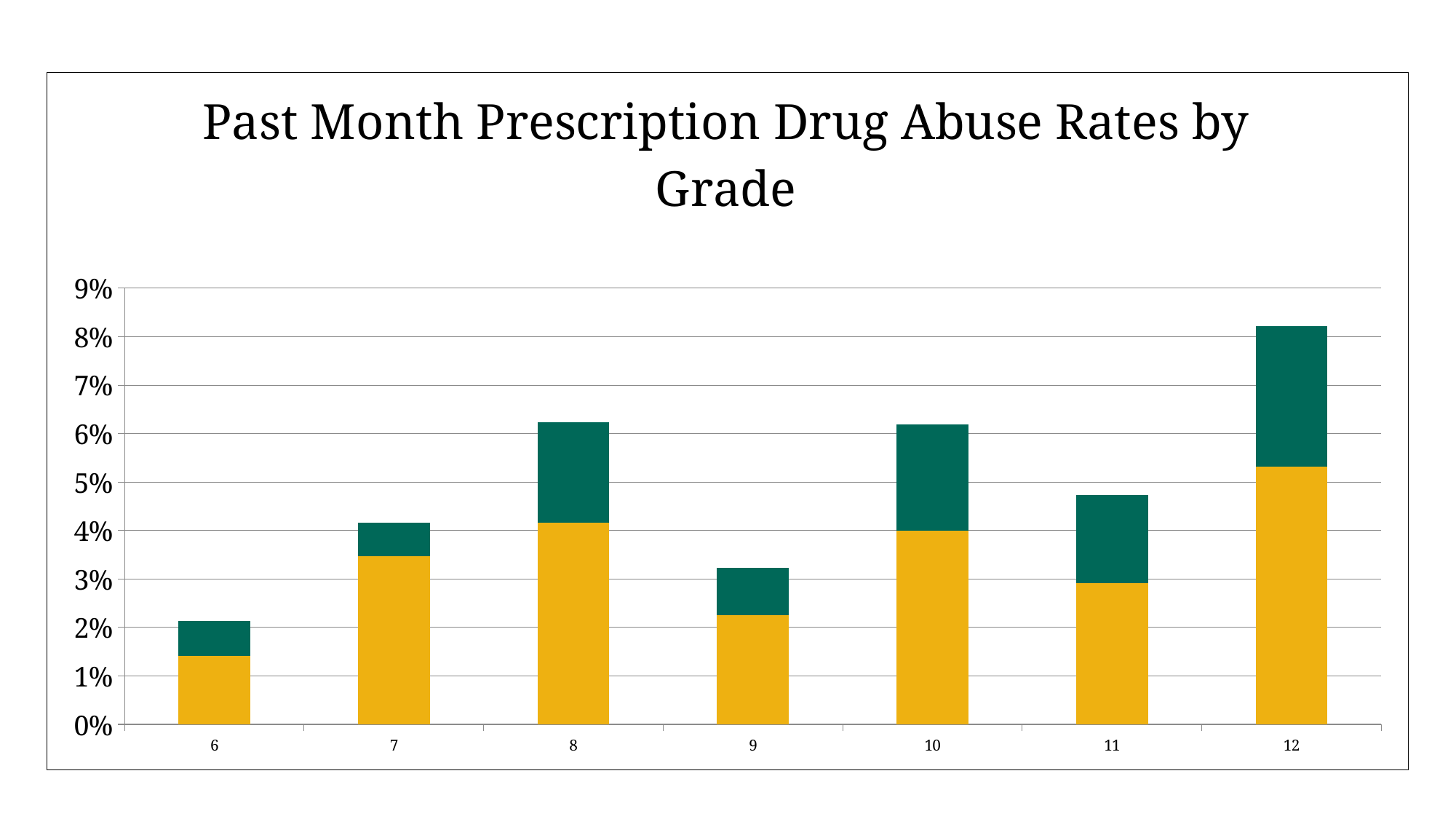
Is the total bar for grade 8 greater or less than 5%? greater Is the total bar for grade 12 greater or less than 7%? greater How many grades are shown on the x axis of the chart? 7 Which grade has a taller total bar, grade 9 or grade 11? 11 Is the total bar for grade 9 greater or less than 4%? less Which grade has the lowest total bar in the chart? 6 What kind of chart is shown on the slide? Stacked bar chart Which grade has the highest total bar in the chart? 12 What is the title of the chart? Past Month Prescription Drug Abuse Rates by Grade Which grade has a taller total bar, grade 6 or grade 7? 7